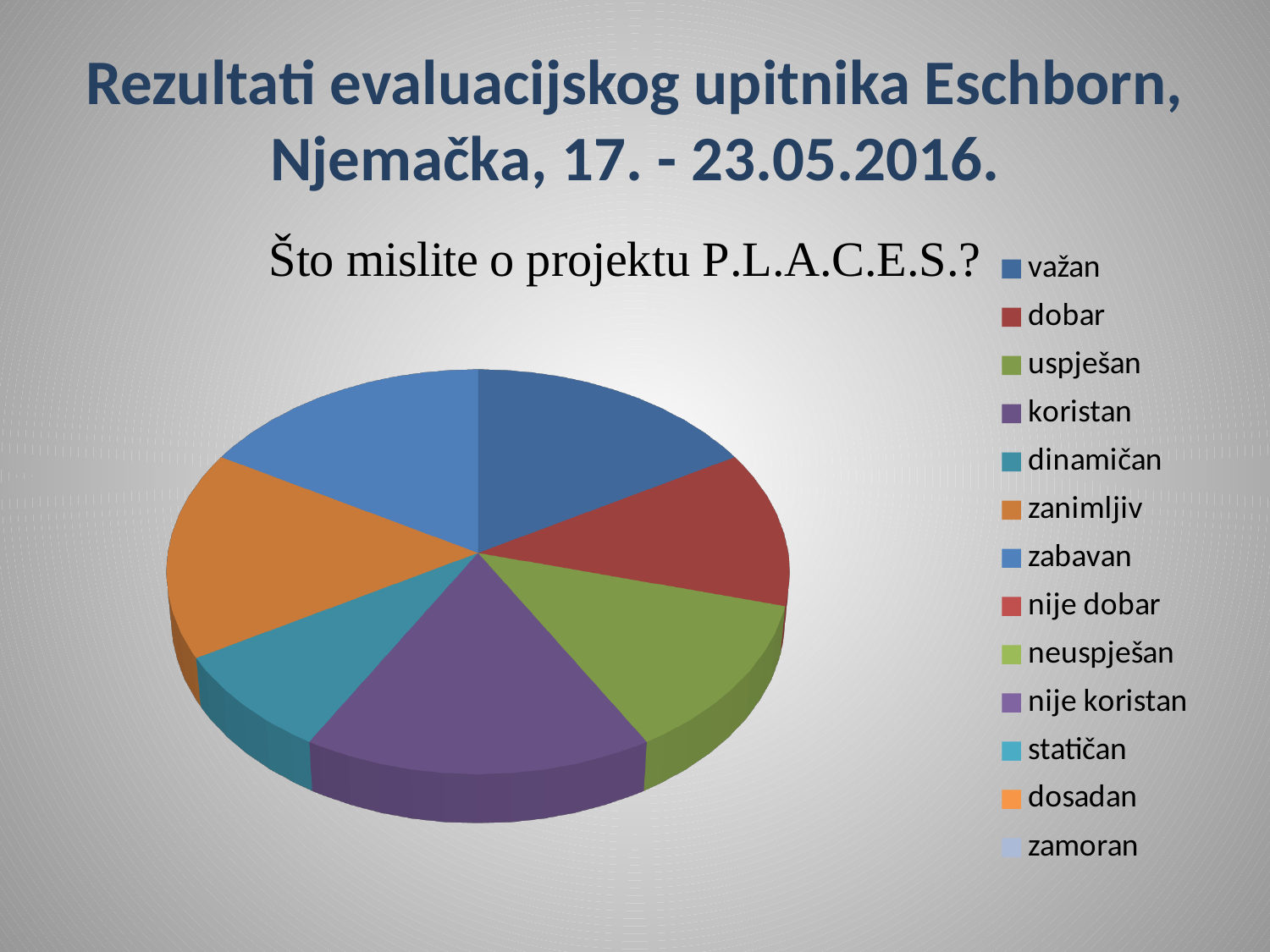
Which slice is larger, koristan or dinamičan? koristan How many entries does the chart legend list? 13 Which slice is larger, koristan or uspješan? koristan What colour is the slice for koristan? purple Which slice is larger, zanimljiv or dobar? zanimljiv What is the title of the chart? Što mislite o projektu P.L.A.C.E.S.? How many slices are visible in the pie? 7 What kind of chart is shown on the slide? pie chart